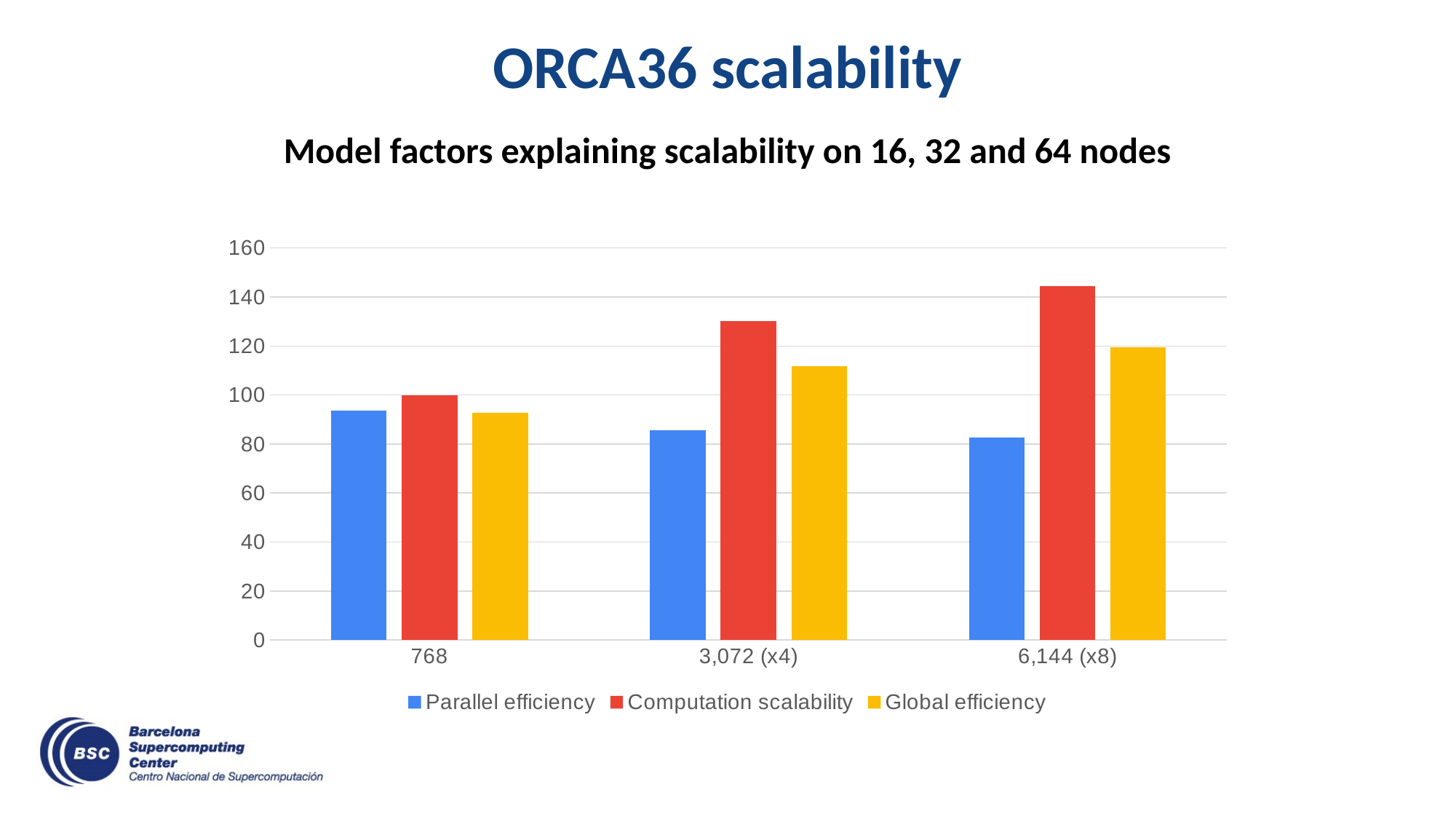
How many categories are shown on the x axis? 3 Is the value for Global efficiency at 3,072 (x4) greater or less than 100? greater Is the value for Parallel efficiency at 6,144 (x8) greater or less than 100? less Does Parallel efficiency rise or fall as the x axis moves from 768 to 6,144 (x8)? fall Which series has the highest value at 6,144 (x8)? Computation scalability What kind of chart is shown on the slide? bar chart Which series has the lowest value at 3,072 (x4)? Parallel efficiency Which is larger: Computation scalability at 3,072 (x4) or Computation scalability at 6,144 (x8)? Computation scalability at 6,144 (x8) What colour represents Global efficiency in the legend? yellow Is the value for Computation scalability at 6,144 (x8) greater or less than 140? greater Does Computation scalability rise or fall as the x axis moves from 768 to 6,144 (x8)? rise How many series does the legend list? 3